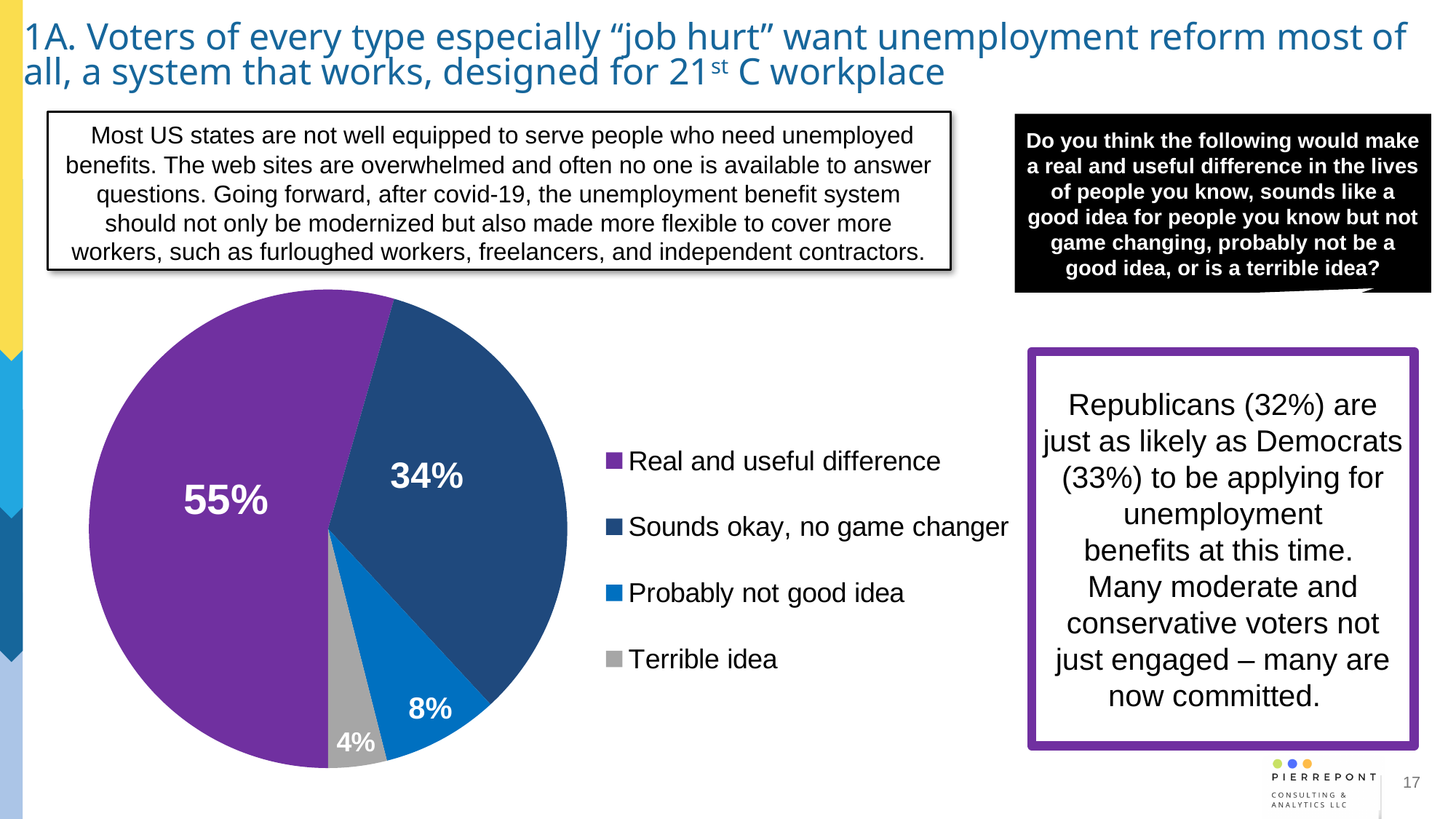
What kind of chart is shown on the slide? pie chart How many entries does the legend list? 4 What colour is the slice for "Sounds okay, no game changer"? dark blue What share of the pie is labelled "Sounds okay, no game changer"? 34% What is the difference in percentage points between "Real and useful difference" and "Sounds okay, no game changer"? 21 Which category has the largest slice of the pie? Real and useful difference What share of the pie is labelled "Probably not good idea"? 8% Which is larger: the slice for "Probably not good idea" or the slice for "Terrible idea"? Probably not good idea What share of the pie is labelled "Terrible idea"? 4% Which category has the smallest slice of the pie? Terrible idea What share of the pie is labelled "Real and useful difference"? 55% How many slices does the pie chart have? 4